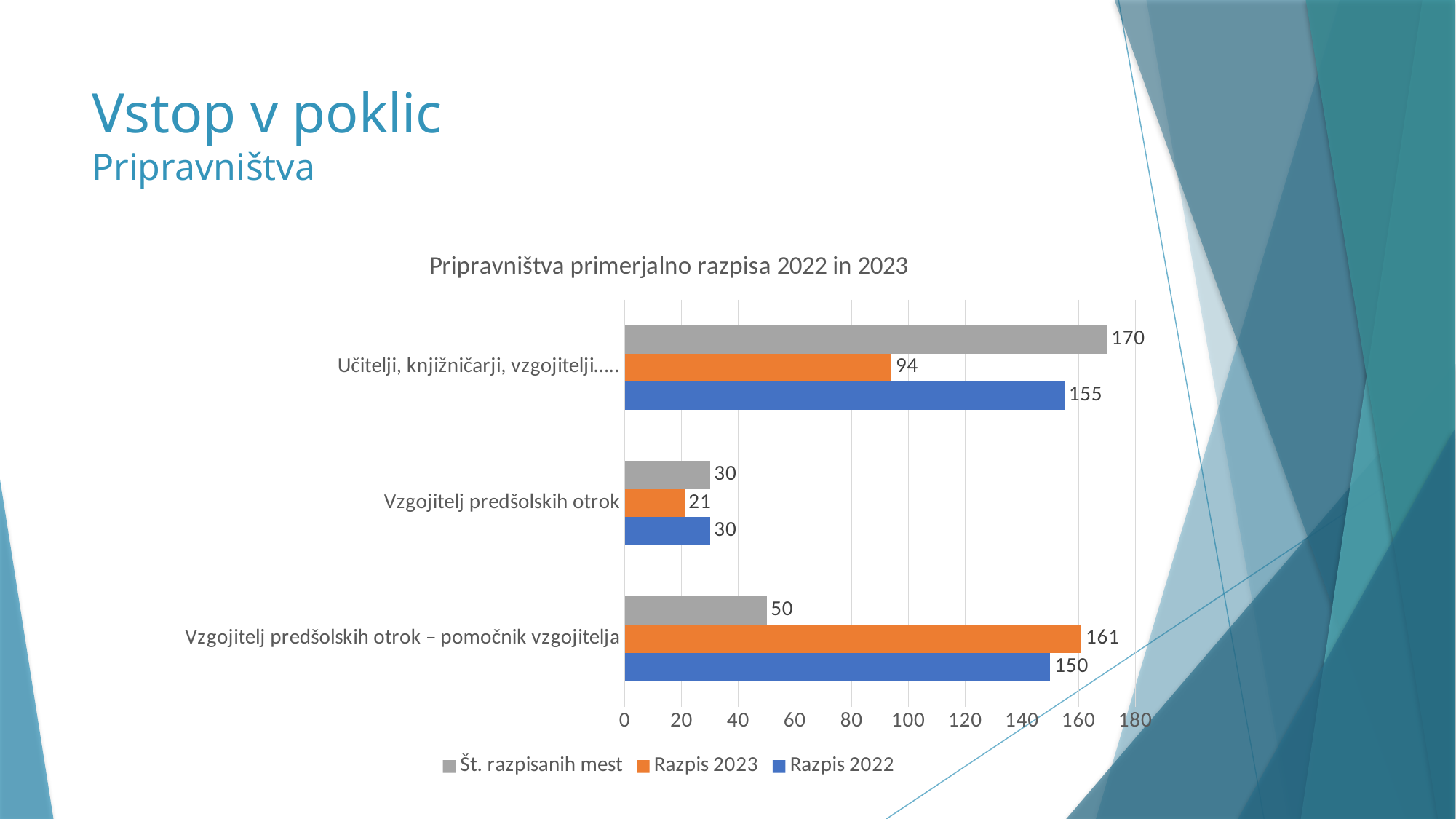
What kind of chart is shown on the slide? Bar chart What is the value of Razpis 2022 for Vzgojitelj predšolskih otrok? 30 Which category has the lowest value for Št. razpisanih mest? Vzgojitelj predšolskih otrok How many categories are shown on the chart? 3 How many series does the legend list? 3 What is the title of the chart? Pripravništva primerjalno razpisa 2022 in 2023 Which is larger for Vzgojitelj predšolskih otrok – pomočnik vzgojitelja: Razpis 2023 or Št. razpisanih mest? Razpis 2023 Is the value of Razpis 2023 for Učitelji, knjižničarji, vzgojitelji….. greater or less than 100? less Which category has the highest value for Razpis 2023? Vzgojitelj predšolskih otrok – pomočnik vzgojitelja What is the difference between Razpis 2022 and Razpis 2023 for Učitelji, knjižničarji, vzgojitelji…..? 61 What is the value of Razpis 2023 for Vzgojitelj predšolskih otrok – pomočnik vzgojitelja? 161 What is the value of Št. razpisanih mest for Učitelji, knjižničarji, vzgojitelji…..? 170